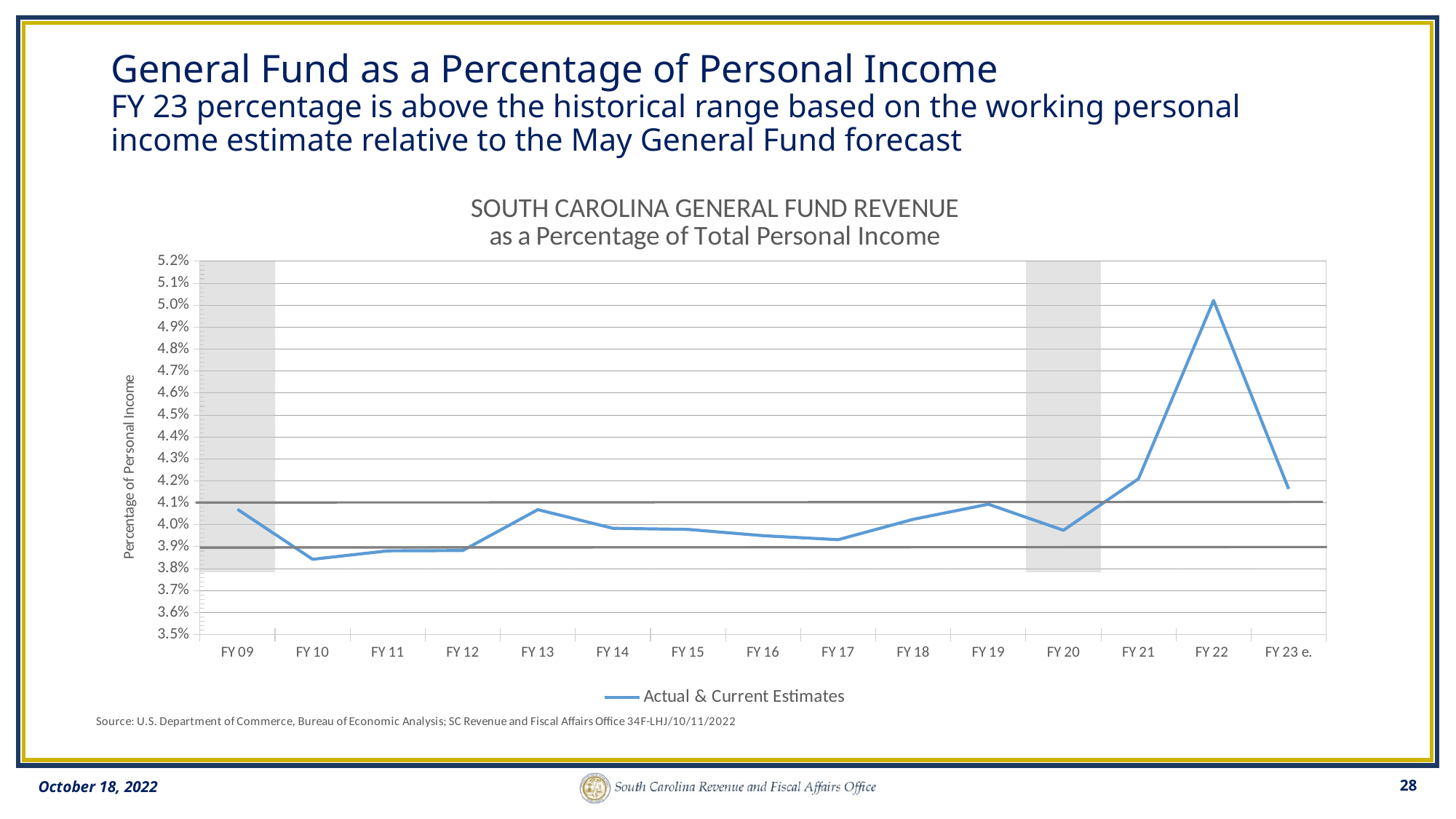
What is the name of the series shown in the legend? Actual & Current Estimates Is the value for FY 17 greater or less than 4.0%? less What kind of chart is shown on the slide? Line chart Which fiscal year has the highest General Fund revenue as a percentage of personal income? FY 22 What is the label on the y axis of the chart? Percentage of Personal Income Is the value for FY 22 greater or less than 4.5%? greater How many fiscal years are plotted on the x axis? 15 Which is larger, the value for FY 19 or the value for FY 20? FY 19 How many series does the legend list? 1 Is the value for FY 23 e. greater or less than 4.1%? greater Do the values rise or fall from FY 20 to FY 22? Rise Which fiscal year has the lowest General Fund revenue as a percentage of personal income? FY 10